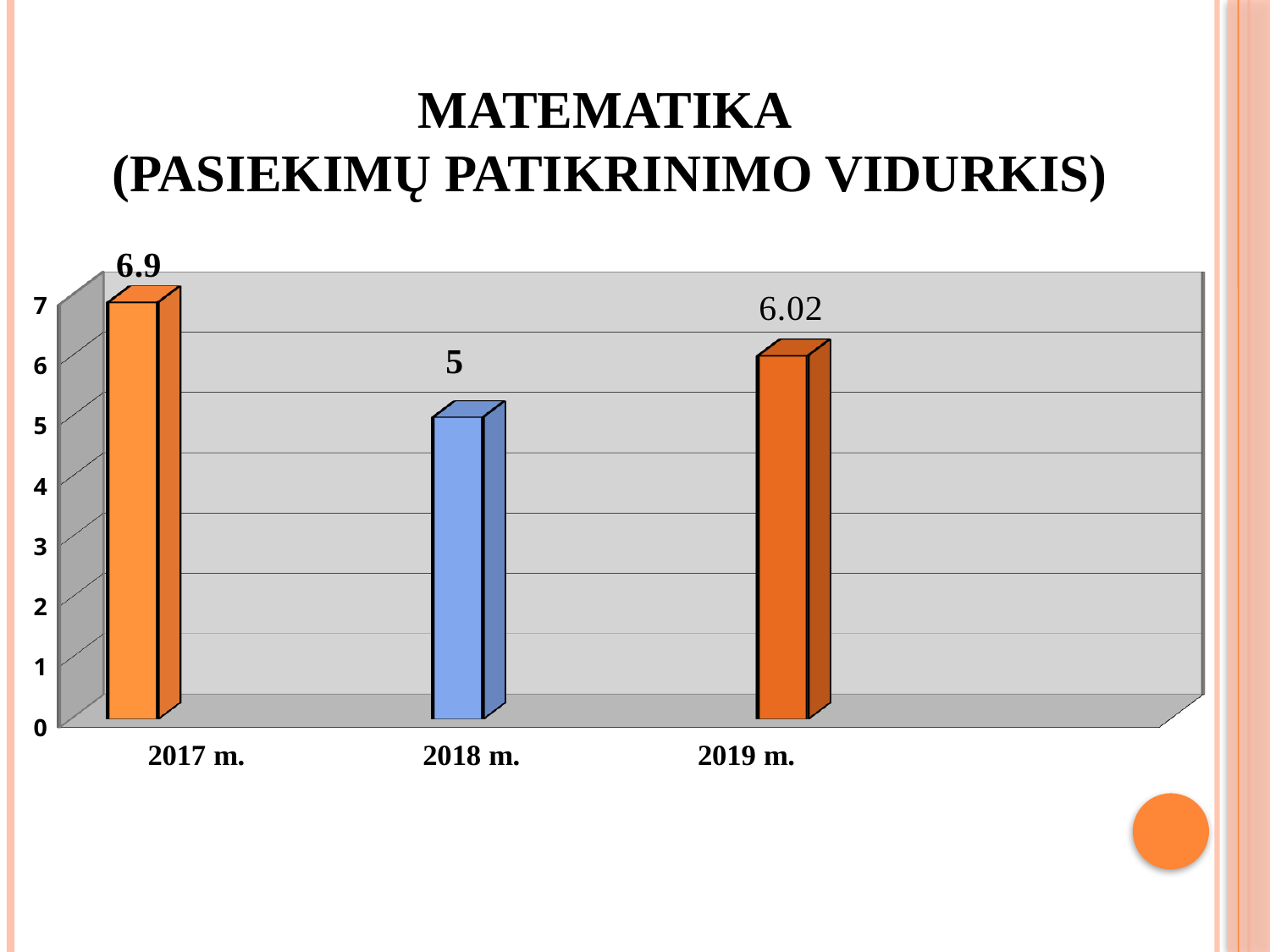
Which is larger, the value for 2017 m. or the value for 2019 m.? 2017 m. What is the difference between the values for 2019 m. and 2018 m.? 1.02 What is the value for 2019 m.? 6.02 What is the title of the chart? MATEMATIKA (PASIEKIMŲ PATIKRINIMO VIDURKIS) How many years are shown on the chart? 3 What is the value for 2017 m.? 6.9 Which year has the lowest value? 2018 m. What kind of chart is shown on the slide? bar chart What is the value for 2018 m.? 5 Which year has the highest value? 2017 m. What is the difference between the values for 2017 m. and 2018 m.? 1.9 Is the value for 2019 m. greater or less than 6? greater